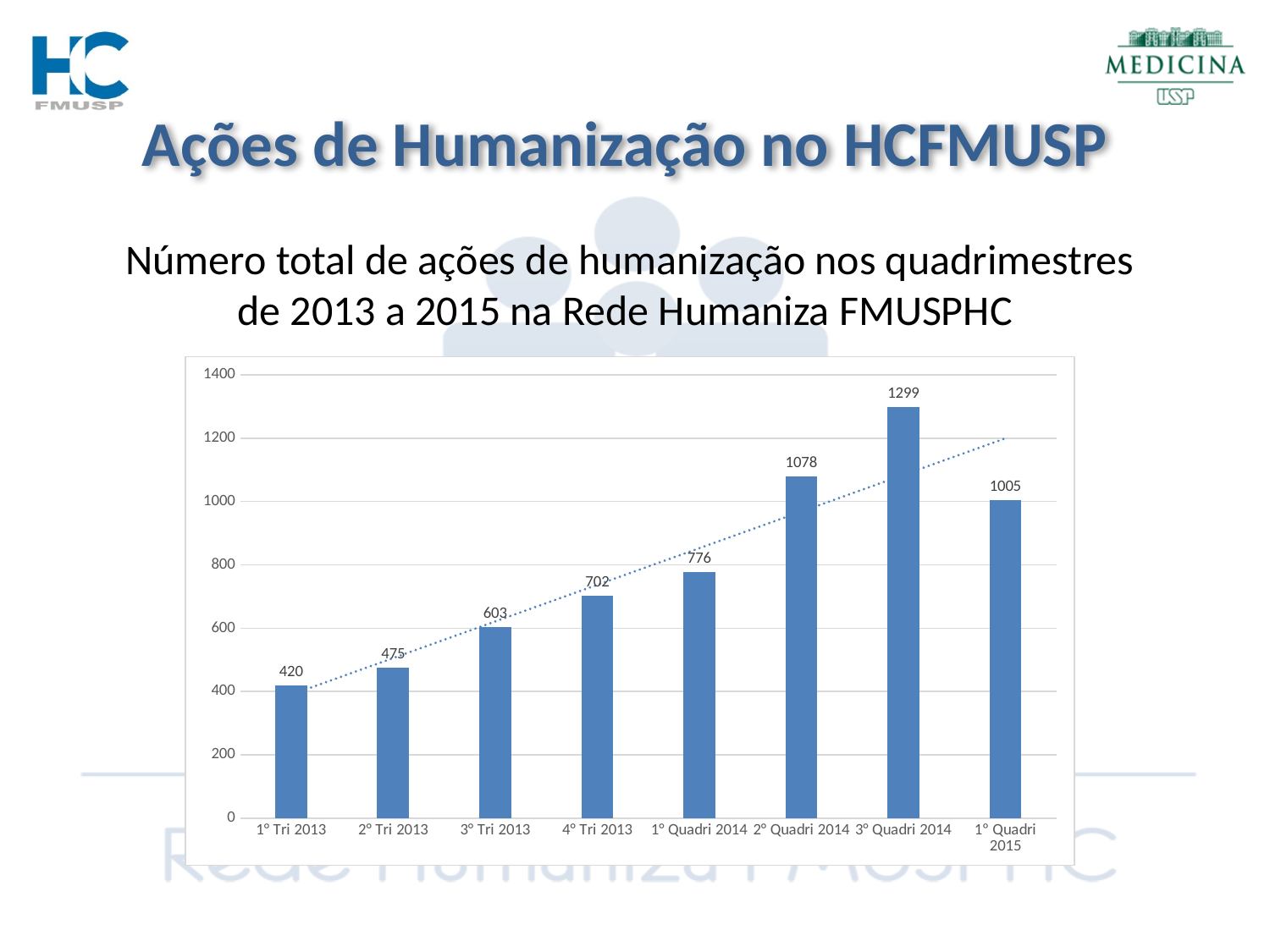
Which category has the lowest value? 1° Tri 2013 Which is larger, the value for 2° Quadri 2014 or the value for 1° Quadri 2015? 2° Quadri 2014 What is the difference between the values for 3° Quadri 2014 and 2° Quadri 2014? 221 What kind of chart is shown on the slide? bar chart Do the values rise or fall from 1° Tri 2013 to 3° Quadri 2014? rise How many categories are shown on the x axis? 8 Is the value for 4° Tri 2013 greater or less than 800? less Which category has the highest value? 3° Quadri 2014 What is the value for 1° Quadri 2015? 1005 What is the difference between the values for 2° Tri 2013 and 1° Tri 2013? 55 What is the value for 1° Tri 2013? 420 What is the value for 3° Quadri 2014? 1299